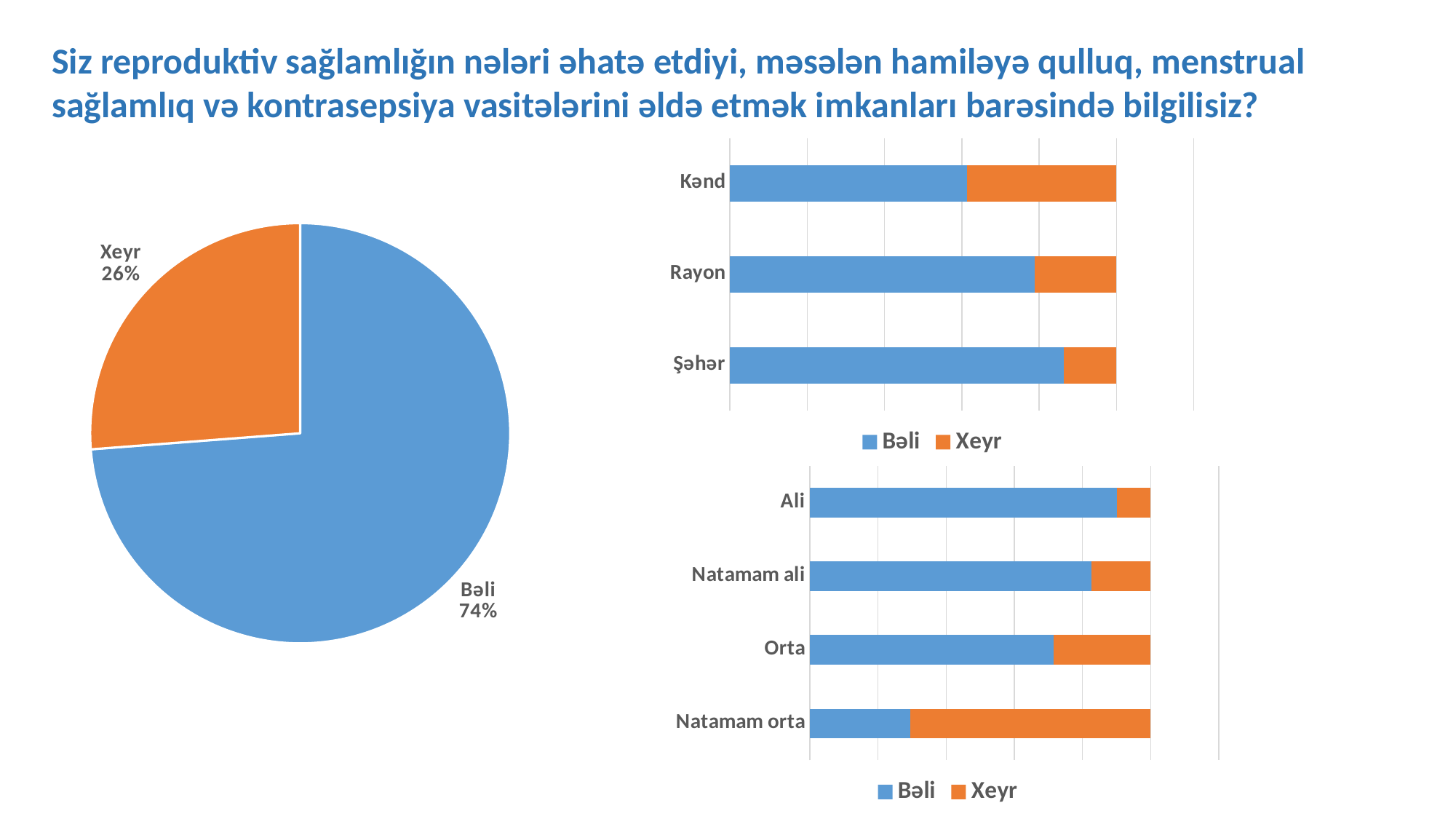
In the pie chart on the left, what share does the Xeyr slice have? 26% What kind of chart is the chart on the left of the slide? Pie chart In the bottom-right chart, which category has the largest Xeyr segment? Natamam orta How many categories does the bottom-right chart (Ali, Natamam ali, Orta, Natamam orta) show? 4 What kind of chart is the top-right chart with the categories Kənd, Rayon and Şəhər? Bar chart How many series does the legend of the top-right chart list? 2 In the pie chart on the left, which slice is larger, Bəli or Xeyr? Bəli In the top-right chart, which category has the largest Bəli segment? Şəhər How many categories does the top-right chart (Kənd, Rayon, Şəhər) show? 3 In the pie chart on the left, what share does the Bəli slice have? 74% In the top-right chart, which category has the largest Xeyr segment? Kənd In the pie chart on the left, how many percentage points larger is the Bəli slice than the Xeyr slice? 48